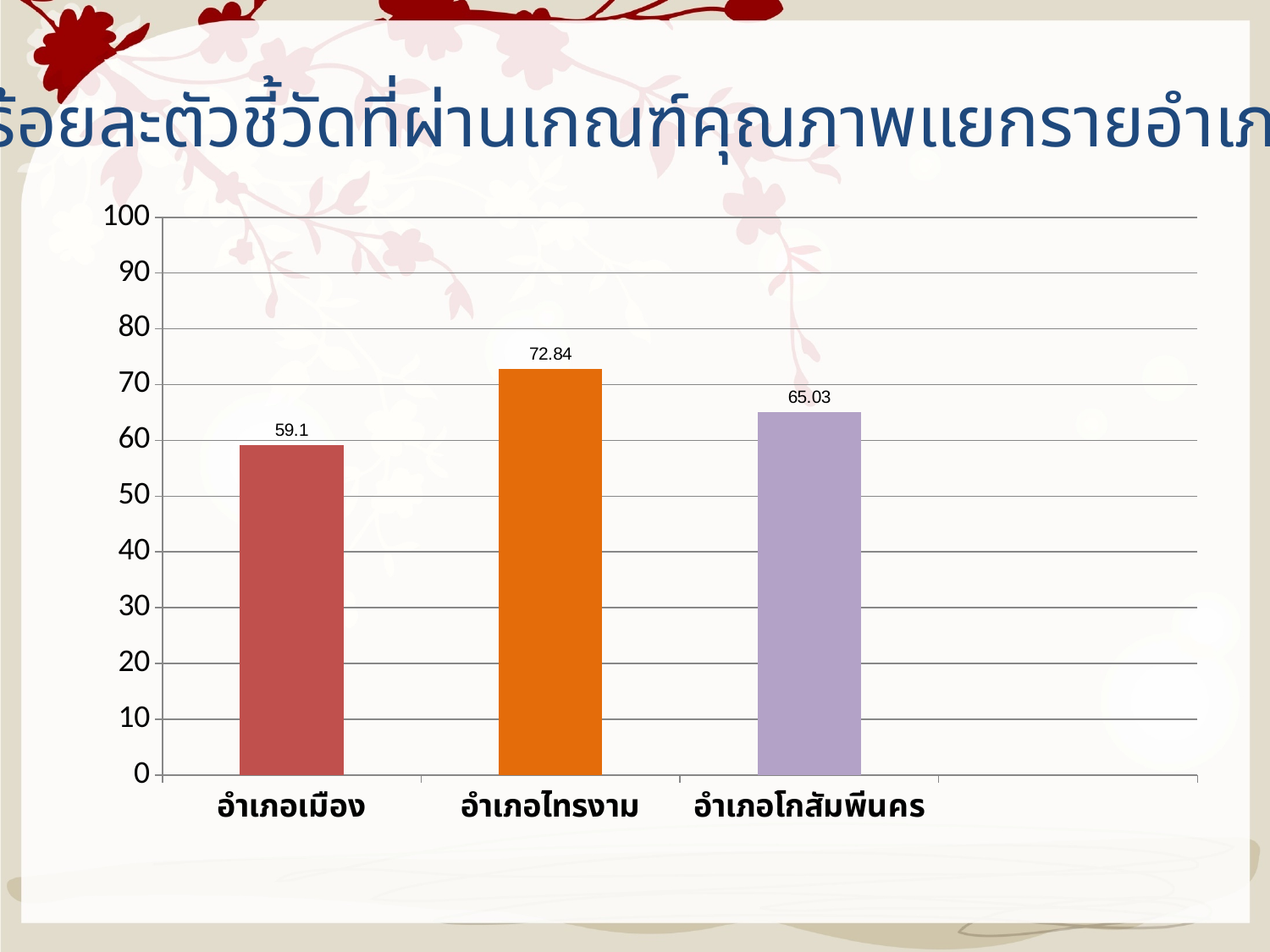
Which is larger, the value for อำเภอโกสัมพีนคร or the value for อำเภอเมือง? อำเภอโกสัมพีนคร How many districts are shown on the chart? 3 What kind of chart is shown on the slide? bar chart Is the value for อำเภอไทรงาม greater or less than 70? greater What is the value for อำเภอโกสัมพีนคร? 65.03 What is the value for อำเภอไทรงาม? 72.84 Which district has the highest value? อำเภอไทรงาม What is the difference between the values for อำเภอไทรงาม and อำเภอเมือง? 13.74 Which district has the lowest value? อำเภอเมือง Is the value for อำเภอเมือง greater or less than 60? less What is the difference between the values for อำเภอโกสัมพีนคร and อำเภอเมือง? 5.93 What is the value for อำเภอเมือง? 59.1